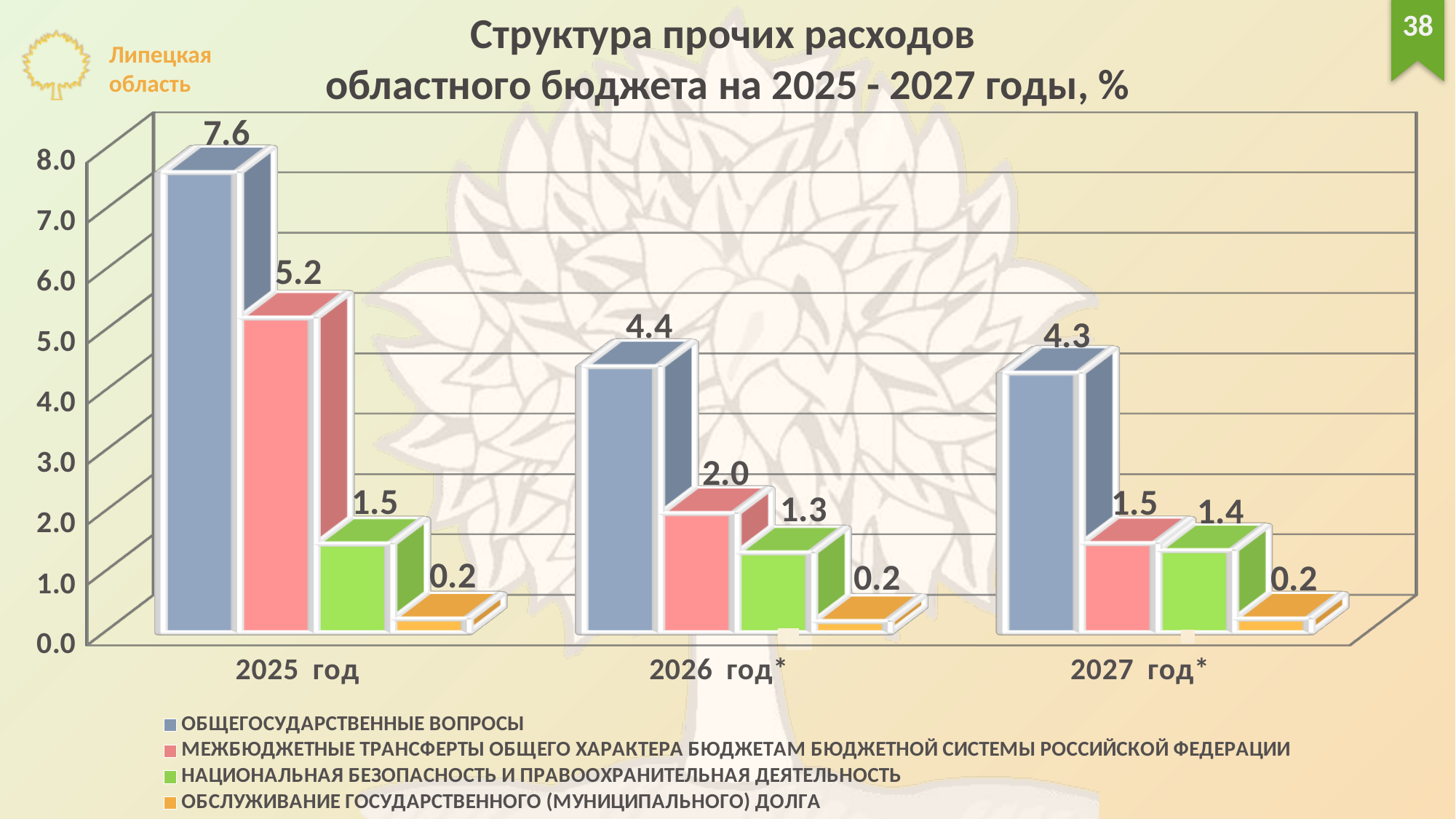
What is the value for НАЦИОНАЛЬНАЯ БЕЗОПАСНОСТЬ И ПРАВООХРАНИТЕЛЬНАЯ ДЕЯТЕЛЬНОСТЬ in 2027 год*? 1.4 How many year categories are shown on the x axis? 3 Which is larger in 2027 год*: МЕЖБЮДЖЕТНЫЕ ТРАНСФЕРТЫ ОБЩЕГО ХАРАКТЕРА БЮДЖЕТАМ БЮДЖЕТНОЙ СИСТЕМЫ РОССИЙСКОЙ ФЕДЕРАЦИИ or НАЦИОНАЛЬНАЯ БЕЗОПАСНОСТЬ И ПРАВООХРАНИТЕЛЬНАЯ ДЕЯТЕЛЬНОСТЬ? МЕЖБЮДЖЕТНЫЕ ТРАНСФЕРТЫ ОБЩЕГО ХАРАКТЕРА БЮДЖЕТАМ БЮДЖЕТНОЙ СИСТЕМЫ РОССИЙСКОЙ ФЕДЕРАЦИИ In which year is the value for ОБЩЕГОСУДАРСТВЕННЫЕ ВОПРОСЫ highest? 2025 год How many series does the legend list? 4 What is the value for МЕЖБЮДЖЕТНЫЕ ТРАНСФЕРТЫ ОБЩЕГО ХАРАКТЕРА БЮДЖЕТАМ БЮДЖЕТНОЙ СИСТЕМЫ РОССИЙСКОЙ ФЕДЕРАЦИИ in 2026 год*? 2.0 What is the difference between the values for ОБЩЕГОСУДАРСТВЕННЫЕ ВОПРОСЫ in 2025 год and 2026 год*? 3.2 What kind of chart is shown on the slide? Bar chart What is the value for ОБЩЕГОСУДАРСТВЕННЫЕ ВОПРОСЫ in 2025 год? 7.6 What is the value for ОБСЛУЖИВАНИЕ ГОСУДАРСТВЕННОГО (МУНИЦИПАЛЬНОГО) ДОЛГА in 2025 год? 0.2 Does the value for МЕЖБЮДЖЕТНЫЕ ТРАНСФЕРТЫ ОБЩЕГО ХАРАКТЕРА БЮДЖЕТАМ БЮДЖЕТНОЙ СИСТЕМЫ РОССИЙСКОЙ ФЕДЕРАЦИИ rise or fall from 2025 год to 2027 год*? Fall Which series has the lowest value in 2026 год*? ОБСЛУЖИВАНИЕ ГОСУДАРСТВЕННОГО (МУНИЦИПАЛЬНОГО) ДОЛГА